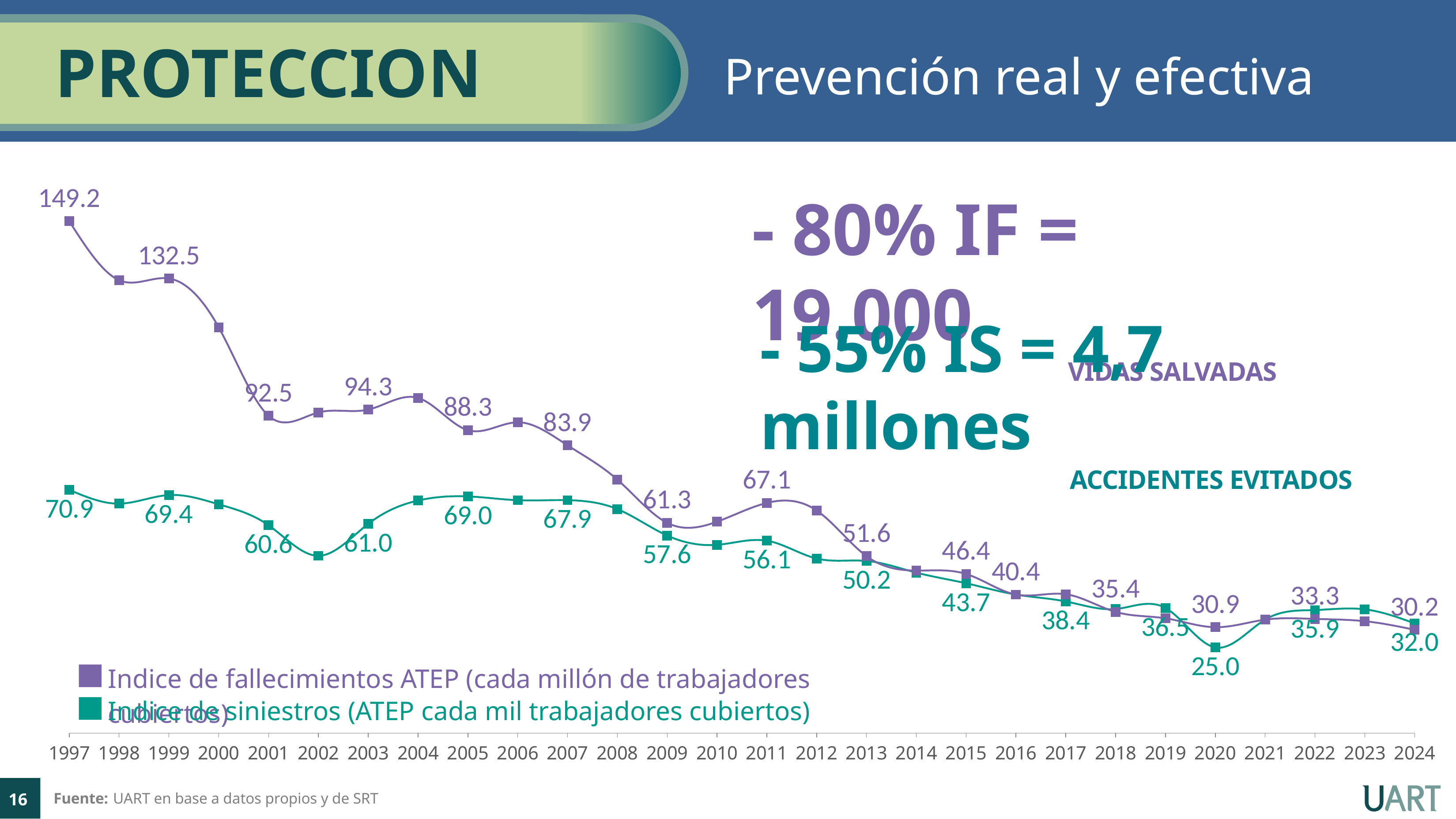
What is the value of the Indice de siniestros series in 1997? 70.9 What is the value of the Indice de siniestros series in 2020? 25.0 Overall, does the Indice de fallecimientos ATEP series rise or fall from 1997 to 2024? Fall In 2024, which series has the higher value: Indice de fallecimientos ATEP or Indice de siniestros? Indice de siniestros How many years are shown on the x axis of the chart? 28 What kind of chart is shown on the slide? Line chart In which year is the Indice de fallecimientos ATEP series at its highest? 1997 What is the value of the Indice de fallecimientos ATEP series in 2024? 30.2 In which year is the Indice de siniestros series at its lowest? 2020 What is the value of the Indice de fallecimientos ATEP series in 1997? 149.2 What is the difference between the Indice de fallecimientos ATEP value and the Indice de siniestros value in 1997? 78.3 How many series does the chart's legend list? 2